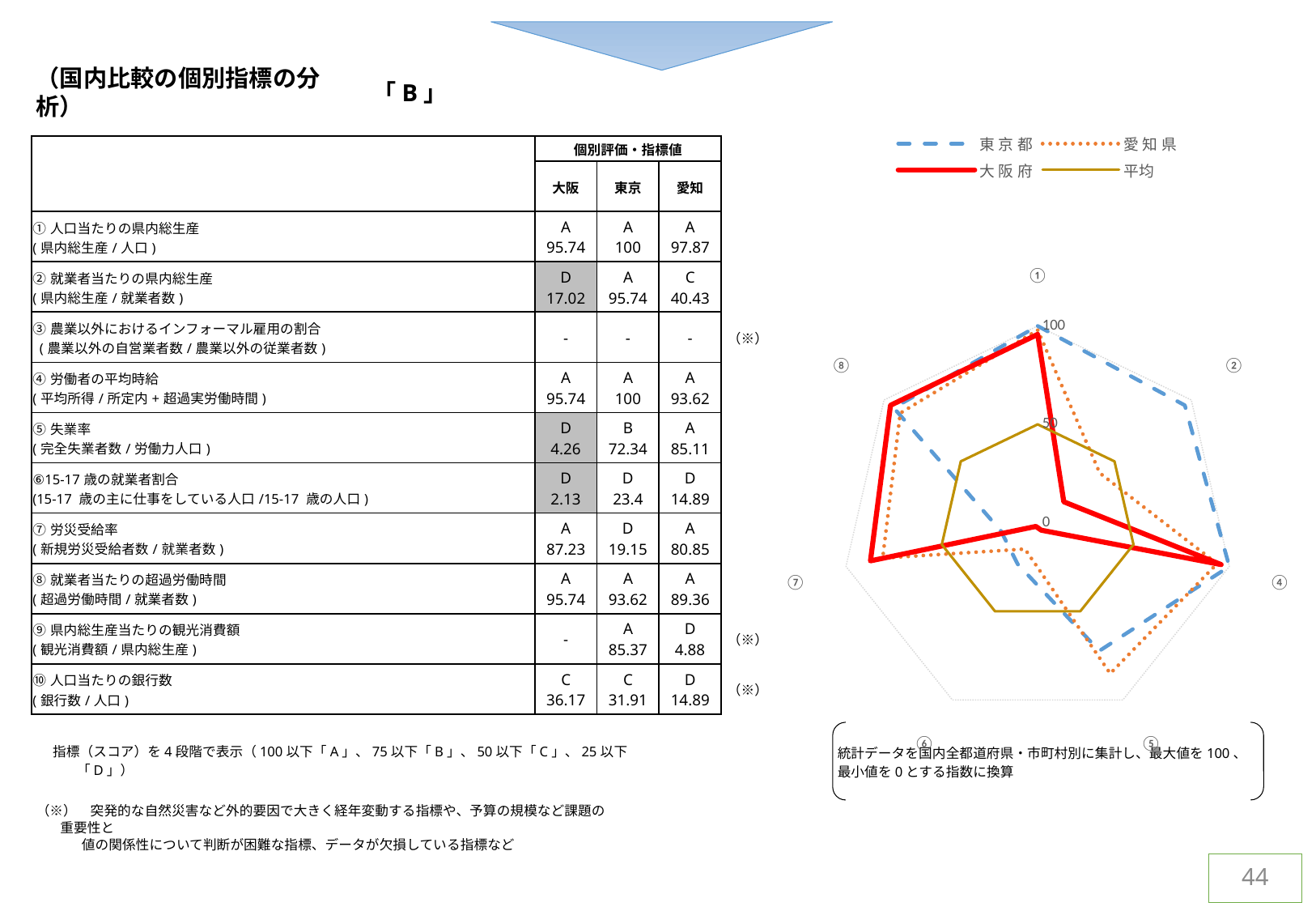
What is the maximum tick value shown on the radar chart's axis? 100 On the radar chart, is the value for 大阪府 on axis ⑤ greater or less than 50? less What kind of chart is shown on the right side of the slide? radar chart How many axes (indicator categories) does the radar chart have? 7 On the radar chart, is the value for 東京都 on axis ⑦ greater or less than 50? less On the radar chart, which series has the larger value on axis ⑦, 大阪府 or 東京都? 大阪府 On the radar chart, which series has the larger value on axis ②, 東京都 or 大阪府? 東京都 How many series does the legend of the radar chart list? 4 On the radar chart, is the value for 大阪府 on axis ② greater or less than 50? less Which series are listed in the legend of the radar chart? 東京都, 愛知県, 大阪府, 平均